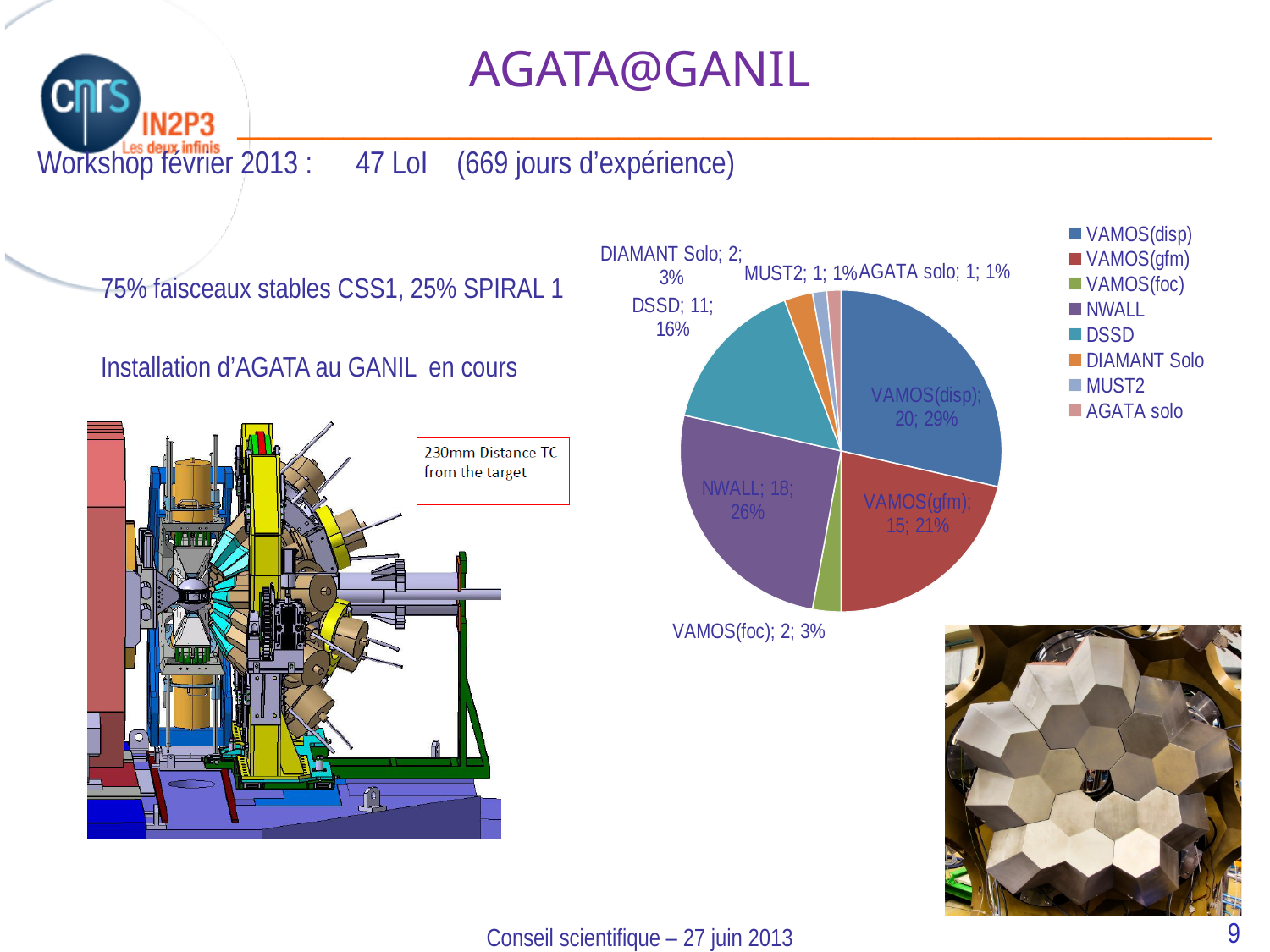
What is the difference between the values for VAMOS(disp) and VAMOS(gfm)? 5 What is the value shown for DSSD in the pie chart? 11 Which legend entry is listed first in the pie chart's legend? VAMOS(disp) How many entries does the legend of the pie chart list? 8 What kind of chart is shown on the slide? pie chart What percentage share does NWALL have in the pie chart? 26% What percentage share does VAMOS(foc) have in the pie chart? 3% Which is larger in the pie chart, NWALL or DSSD? NWALL How many slices does the pie chart have? 8 What is the value shown for VAMOS(disp) in the pie chart? 20 What is the value shown for MUST2 in the pie chart? 1 Which category has the largest slice in the pie chart? VAMOS(disp)